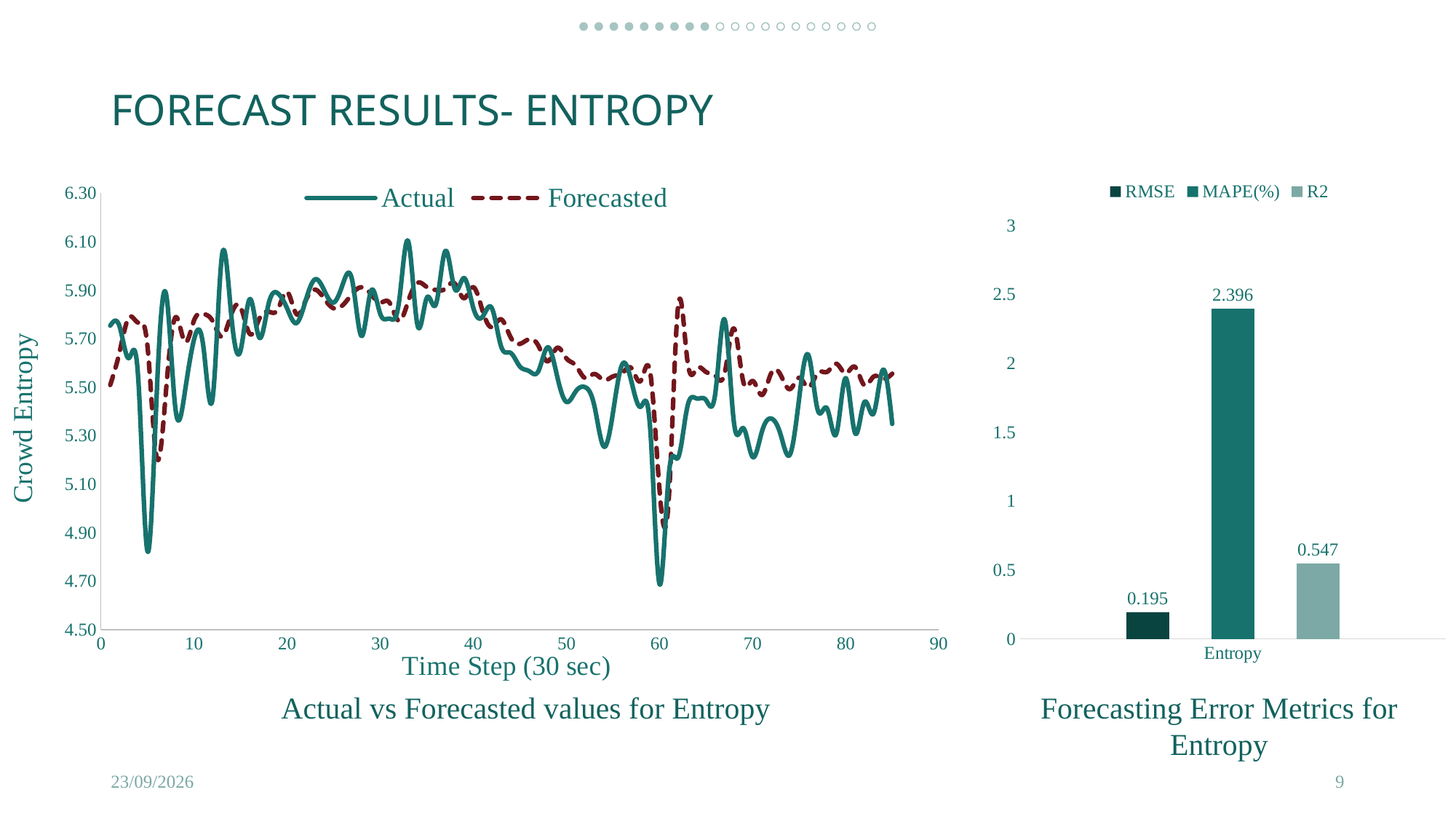
In the 'Actual vs Forecasted values for Entropy' chart, how many series does the legend list? 2 In the 'Forecasting Error Metrics for Entropy' chart, what is the difference between the MAPE(%) value and the R2 value? 1.849 In the 'Forecasting Error Metrics for Entropy' chart, which metric has the highest value? MAPE(%) In the 'Forecasting Error Metrics for Entropy' chart, how many series does the legend list? 3 In the 'Forecasting Error Metrics for Entropy' chart, which is larger, RMSE or R2? R2 In the 'Forecasting Error Metrics for Entropy' chart, which metric has the lowest value? RMSE What kind of chart is 'Forecasting Error Metrics for Entropy'? Bar chart What kind of chart is 'Actual vs Forecasted values for Entropy'? Line chart In the 'Forecasting Error Metrics for Entropy' chart, what is the value of MAPE(%)? 2.396 In the 'Actual vs Forecasted values for Entropy' chart, what is the label of the x axis? Time Step (30 sec) In the 'Forecasting Error Metrics for Entropy' chart, what is the value of RMSE? 0.195 In the 'Forecasting Error Metrics for Entropy' chart, what is the value of R2? 0.547